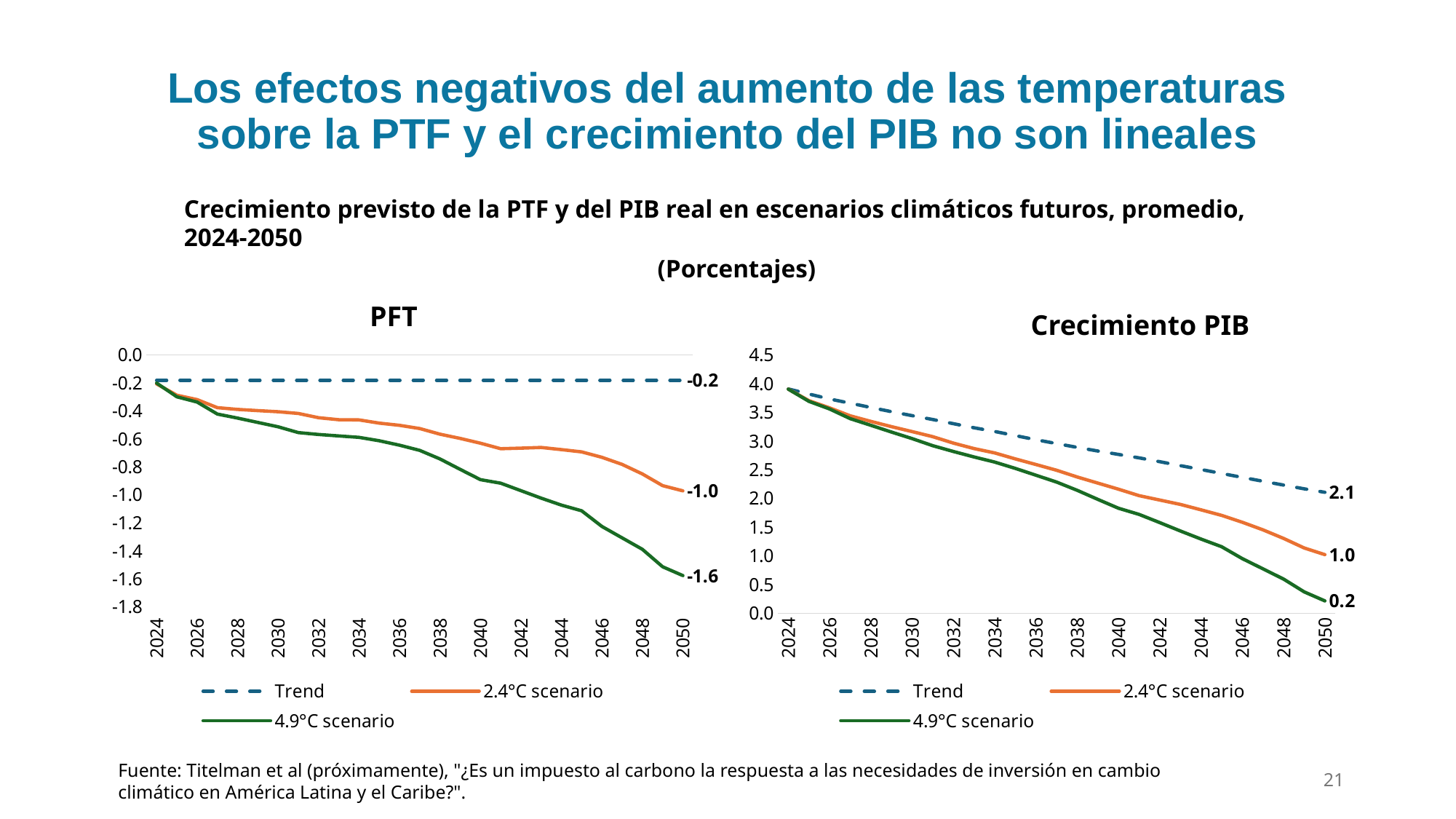
In the Crecimiento PIB chart, what is the value of the 4.9°C scenario in 2050? 0.2 How many series does the legend of the PFT chart list? 3 In the PFT chart, what is the difference between the 2.4°C scenario and the 4.9°C scenario in 2050? 0.6 In the Crecimiento PIB chart, what is the value of the Trend series in 2050? 2.1 What kind of chart is the Crecimiento PIB chart? Line chart In the Crecimiento PIB chart, which series has the lowest value in 2050? 4.9°C scenario In the PFT chart, what is the value of the 4.9°C scenario in 2050? -1.6 In the Crecimiento PIB chart, what is the difference between the Trend value and the 2.4°C scenario value in 2050? 1.1 In the PFT chart, which series has the highest value in 2050? Trend In the PFT chart, what is the value of the 2.4°C scenario in 2050? -1.0 In the Crecimiento PIB chart, is the value of the 4.9°C scenario in 2040 greater or less than 2.0? less In the Crecimiento PIB chart, is the 2.4°C scenario value in 2050 greater or less than the Trend value in 2050? less